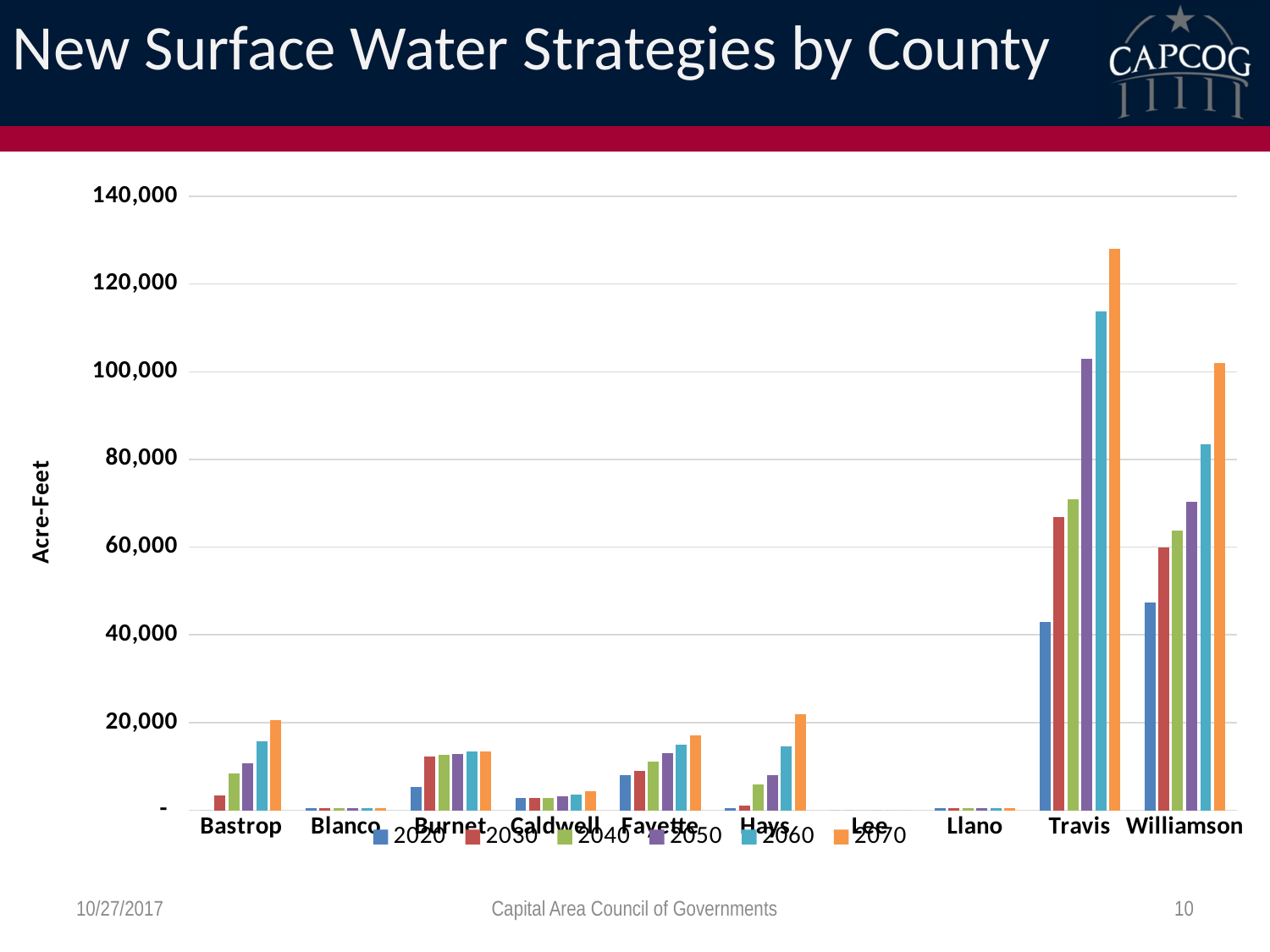
What type of chart is shown on the slide? bar chart What is the label on the chart's vertical axis? Acre-Feet How many counties are shown on the x axis of the chart? 10 Do the values for Travis rise or fall from 2020 to 2070? rise Which is larger, the 2070 value for Travis or the 2070 value for Williamson? Travis Is the 2060 value for Travis greater or less than 100,000? greater How many series does the chart's legend list? 6 Is the 2020 value for Williamson greater or less than 60,000? less Which county has the tallest bar in the chart? Travis Is the 2050 value for Williamson greater or less than 80,000? less Which county has the highest value for 2070? Travis